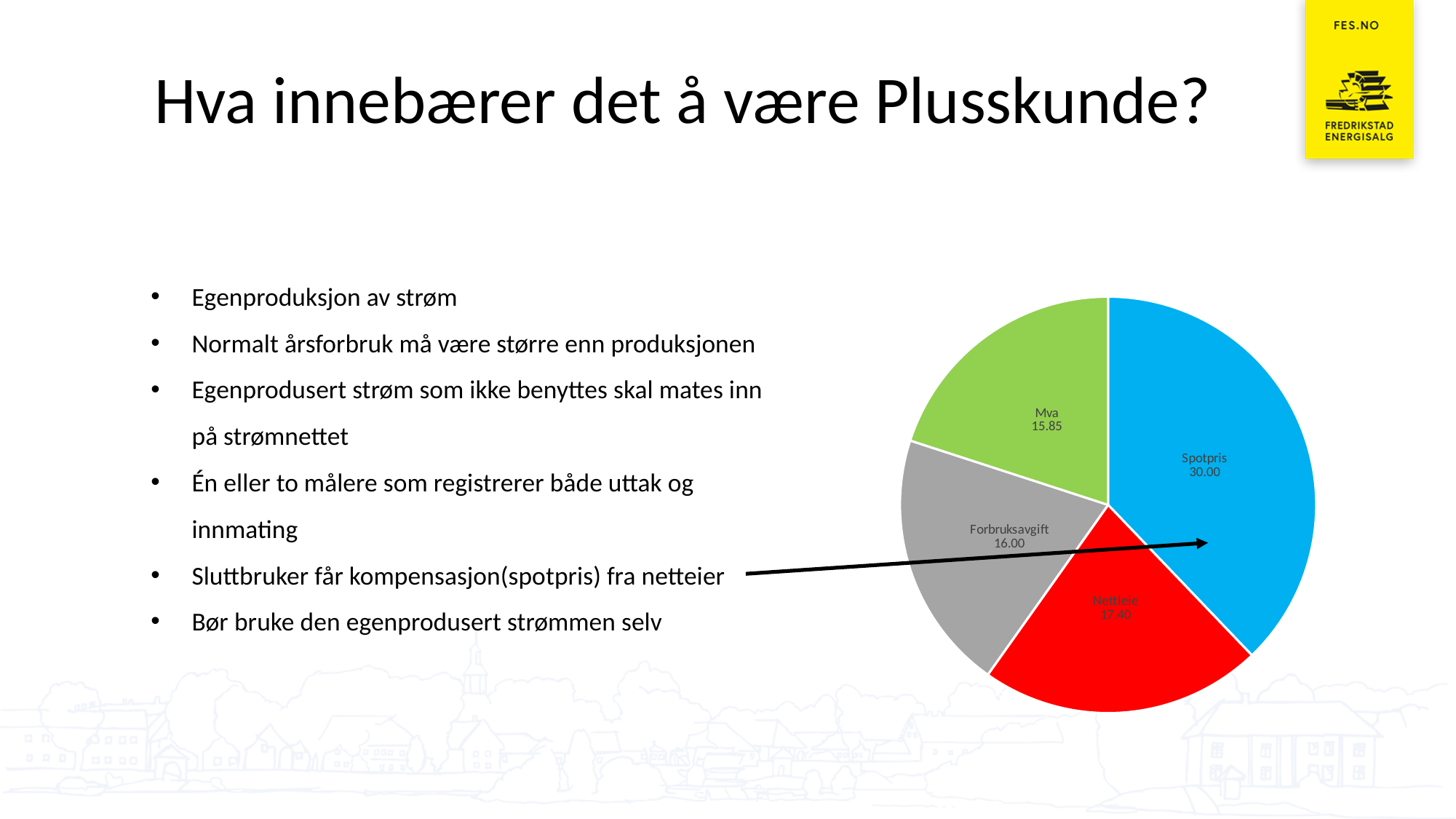
What colour is the Spotpris slice in the pie chart? blue What is the difference between the Spotpris value and the Nettleie value in the pie chart? 12.60 What is the value shown for Nettleie in the pie chart? 17.40 Which slice of the pie chart has the smallest value? Mva What is the difference between the Nettleie value and the Forbruksavgift value in the pie chart? 1.40 Which is larger in the pie chart, Nettleie or Forbruksavgift? Nettleie What kind of chart is shown on the slide? pie chart What is the value shown for Mva in the pie chart? 15.85 What is the value shown for Spotpris in the pie chart? 30.00 What is the value shown for Forbruksavgift in the pie chart? 16.00 Which slice of the pie chart has the largest value? Spotpris How many slices does the pie chart have? 4